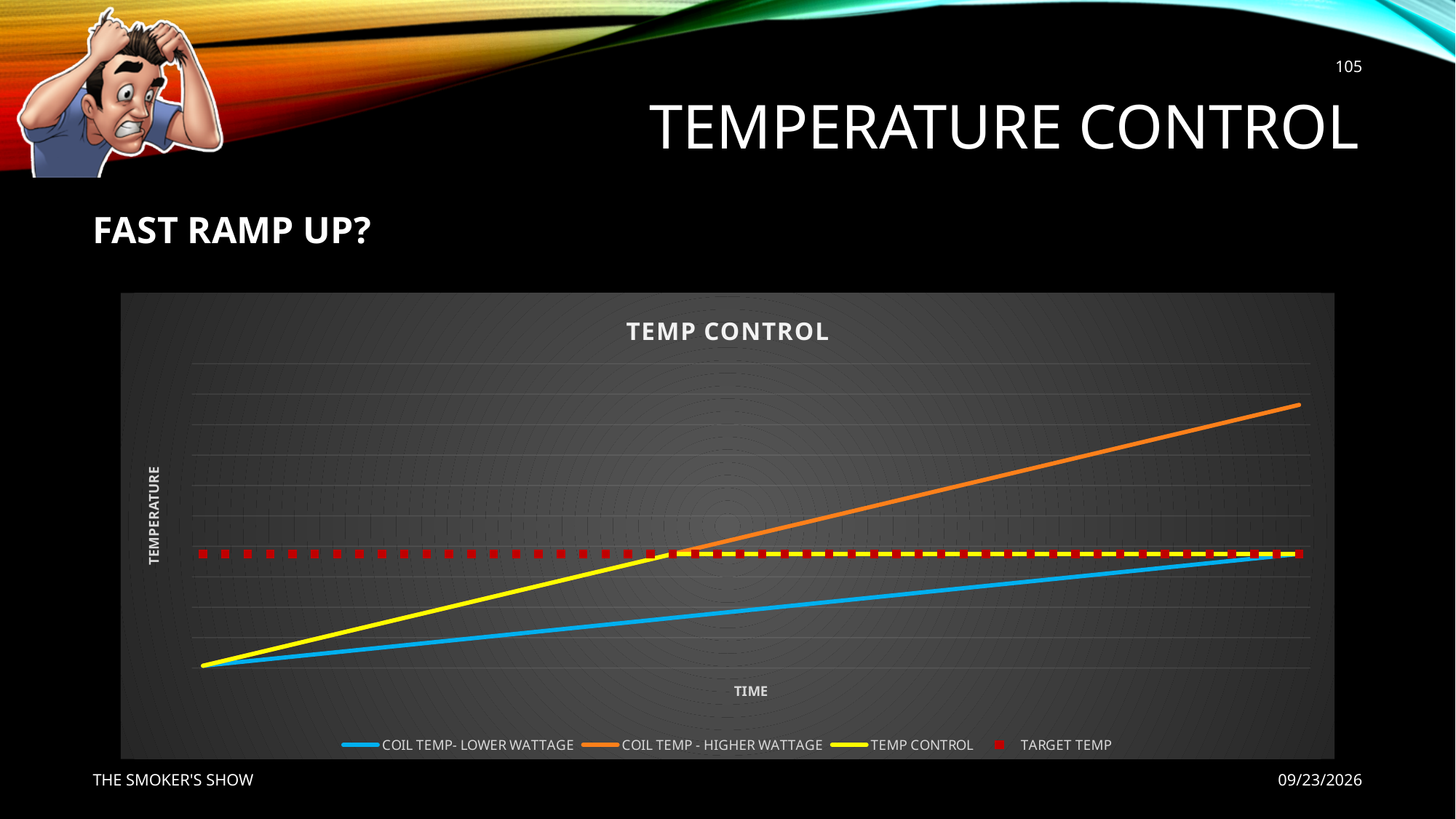
What kind of chart is shown on the slide? line chart Which series reaches the highest temperature at the right end of the chart? COIL TEMP - HIGHER WATTAGE What is the title of the chart? TEMP CONTROL What is the label on the vertical axis of the chart? TEMPERATURE Does the TEMP CONTROL series keep rising after it reaches the TARGET TEMP line, or does it level off? level off How many series does the legend of the TEMP CONTROL chart list? 4 Which series rises more steeply: COIL TEMP - HIGHER WATTAGE or COIL TEMP- LOWER WATTAGE? COIL TEMP - HIGHER WATTAGE Does the TARGET TEMP series rise, fall, or stay flat along the time axis? stay flat At the right end of the chart, which is higher: COIL TEMP - HIGHER WATTAGE or COIL TEMP- LOWER WATTAGE? COIL TEMP - HIGHER WATTAGE Does the COIL TEMP - HIGHER WATTAGE series rise or fall along the time axis? rise